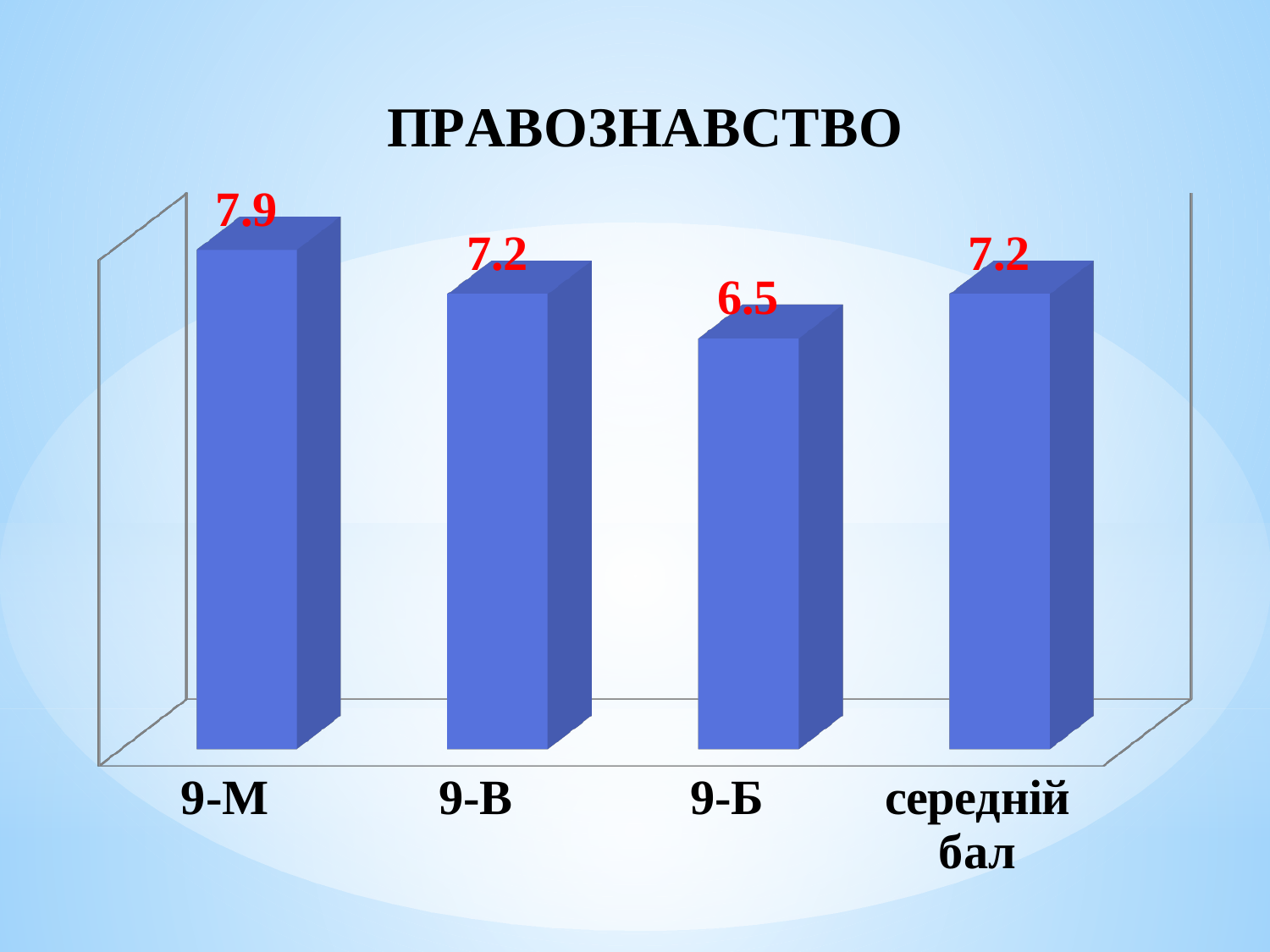
Which category has the highest value? 9-М Which category has the lowest value? 9-Б What is the value for середній бал? 7.2 What kind of chart is shown on the slide? bar chart What is the difference between the values for 9-М and 9-Б? 1.4 Which is larger, the value for 9-М or the value for 9-В? 9-М How many categories are shown on the chart? 4 What is the value for 9-М? 7.9 What is the value for 9-Б? 6.5 What is the title of the chart? ПРАВОЗНАВСТВО What is the difference between the values for 9-В and 9-Б? 0.7 What is the value for 9-В? 7.2